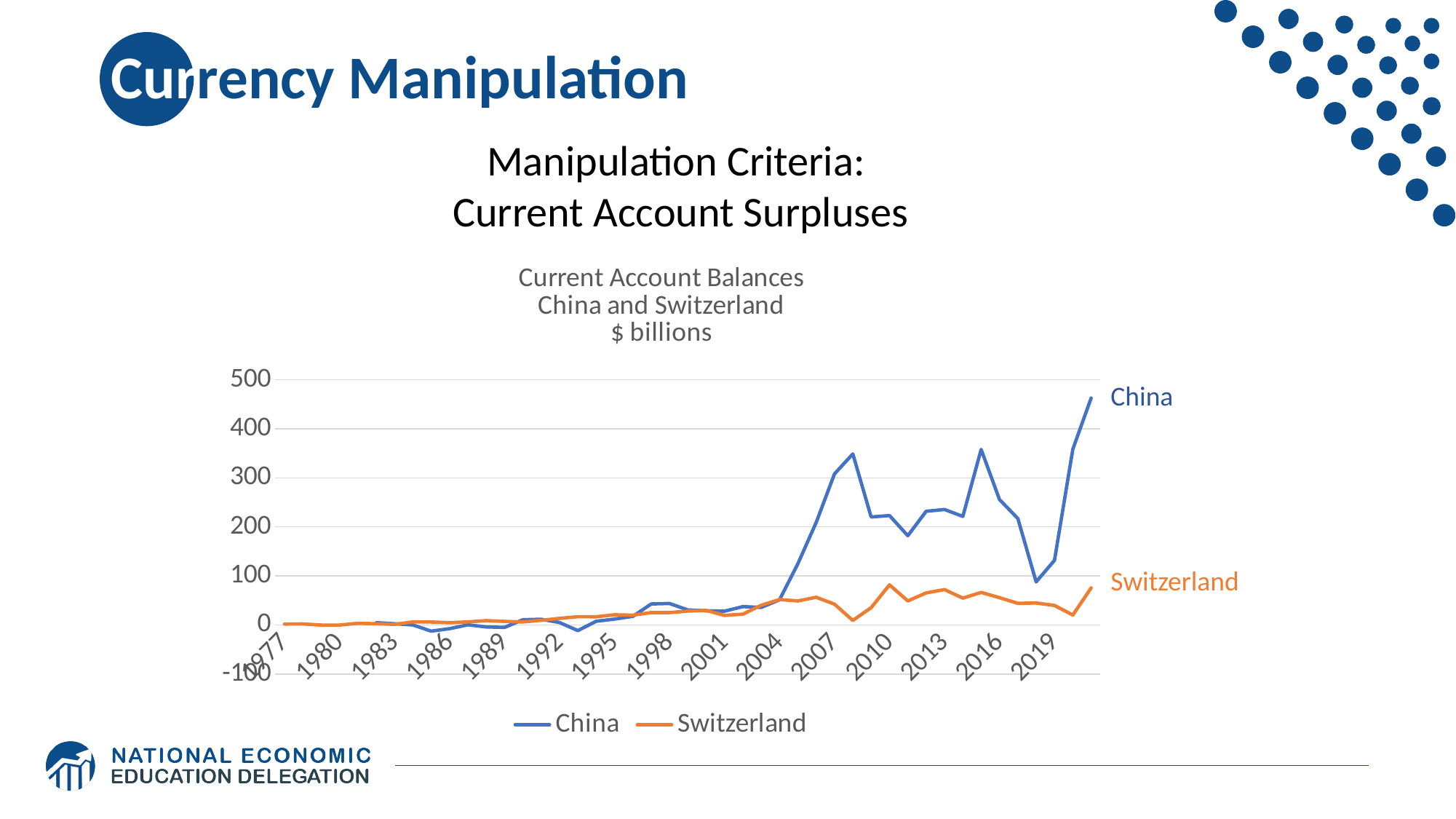
Is the highest point of the Switzerland line greater or less than 100? less At the right end of the chart, which series has the larger value, China or Switzerland? China What unit is given in the chart title? $ billions Is the highest point of the China line greater or less than 400? greater Is the value for China in 2004 greater or less than 100? less Which two countries are plotted in the chart? China and Switzerland Does the China line overall rise or fall from 1977 to the end of the series? rise How many series does the legend list? 2 Which series reaches the highest value on the chart? China What kind of chart is shown on the slide? line chart How many year labels are shown on the x axis? 15